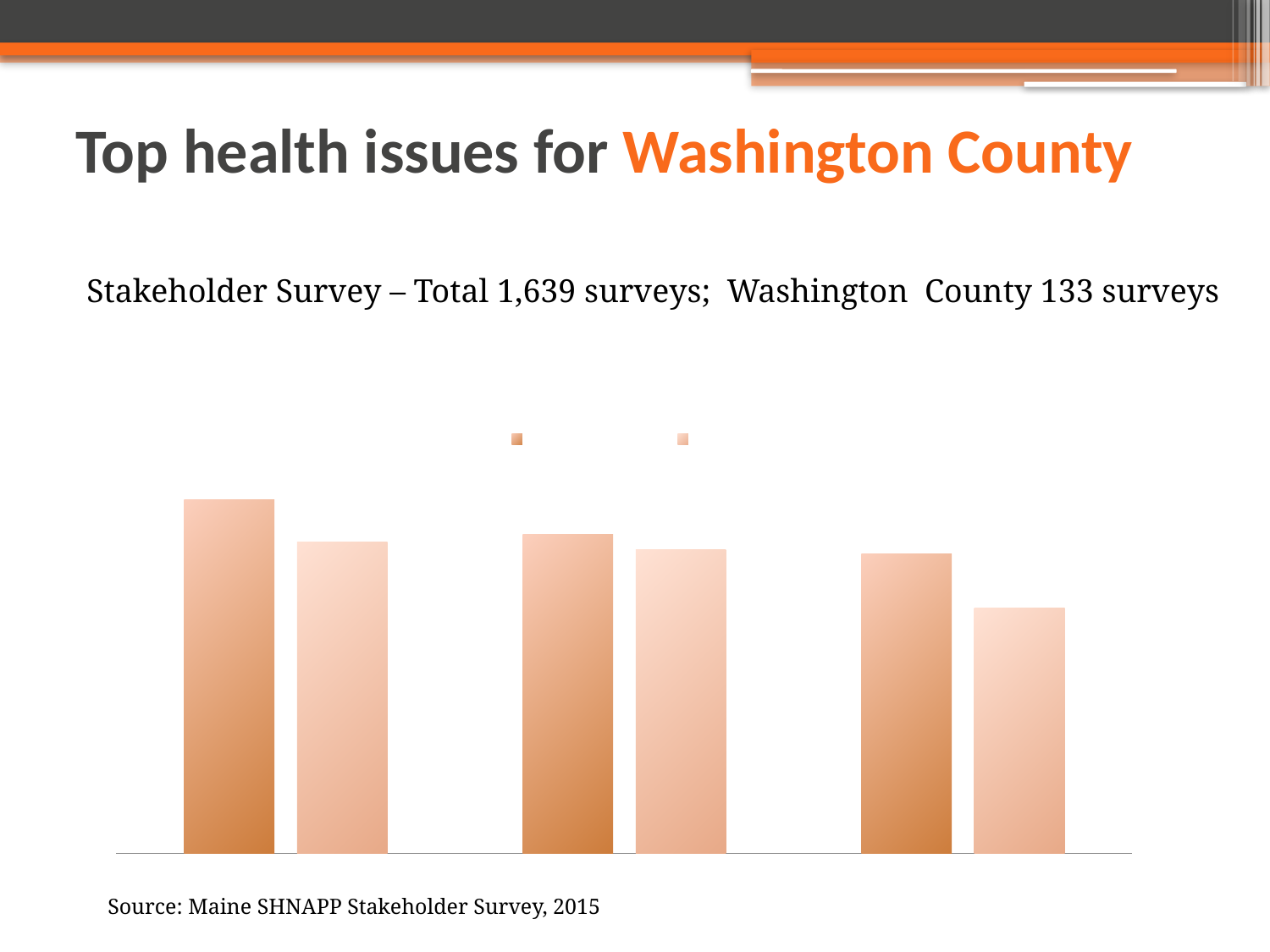
Is the darker orange bar in the middle group taller or shorter than the darker orange bar in the leftmost group? shorter How many series does the chart's legend list? 2 What colour scheme are the bars drawn in? shades of orange Which bar is the shortest on the chart? the lighter bar in the rightmost group How many bars are plotted in total on the chart? 6 In the rightmost group, is the darker orange bar or the lighter bar taller? the darker orange bar What kind of chart is shown on the slide? bar chart In the leftmost group, is the darker orange bar or the lighter bar taller? the darker orange bar How many groups of bars (categories) does the chart show? 3 Which bar is the tallest on the chart? the darker orange bar in the leftmost group Do the bar heights rise or fall from left to right across the chart? fall Does the chart display data labels on the bars? no